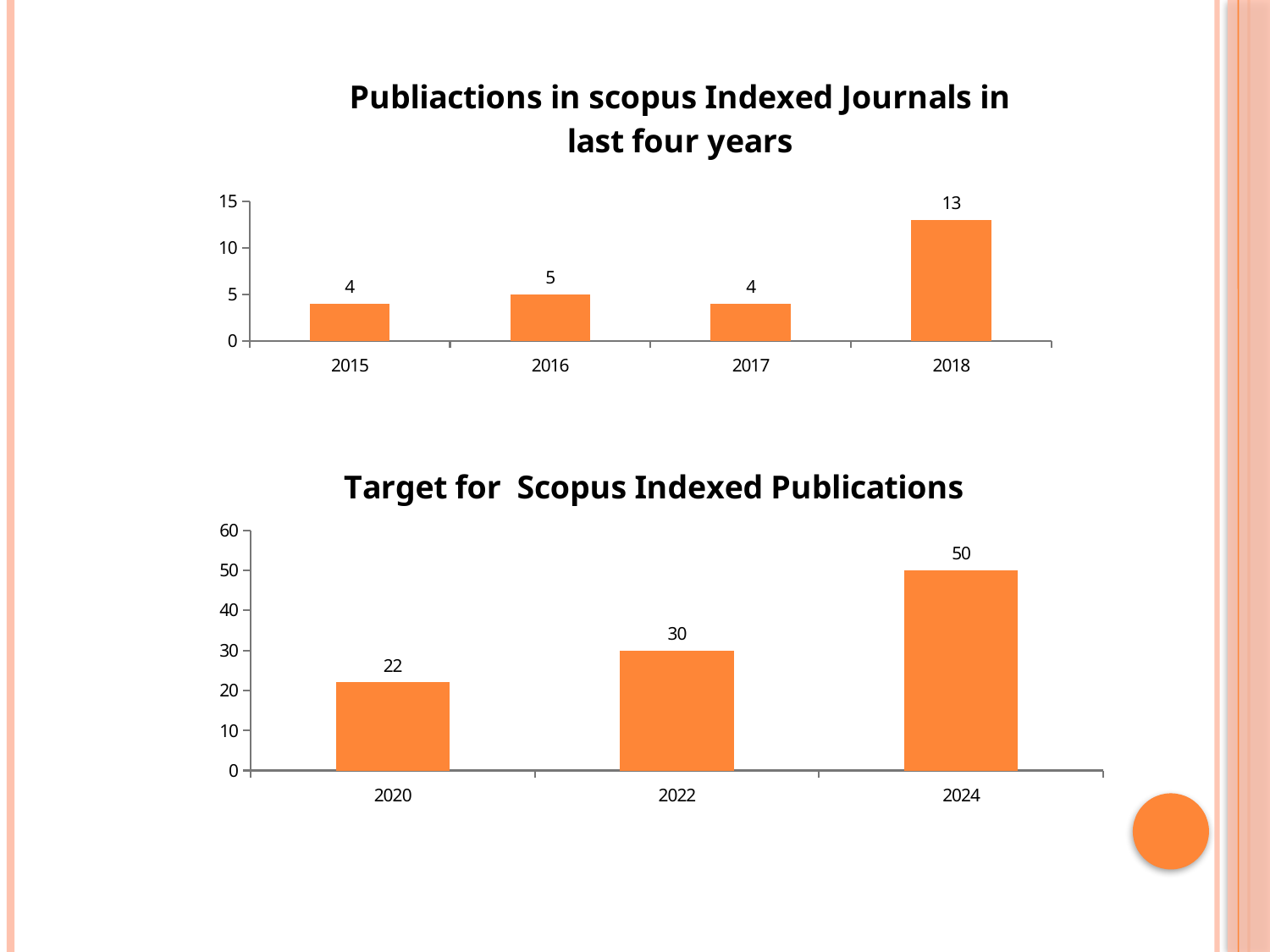
In the top chart (Publiactions in scopus Indexed Journals in last four years), what is the value for 2016? 5 In the bottom chart (Target for Scopus Indexed Publications), how many years are shown on the x axis? 3 In the top chart (Publiactions in scopus Indexed Journals in last four years), is the value for 2018 greater or less than 10? greater In the top chart (Publiactions in scopus Indexed Journals in last four years), how many years are shown on the x axis? 4 In the top chart (Publiactions in scopus Indexed Journals in last four years), what is the value for 2018? 13 What kind of chart is the bottom chart (Target for Scopus Indexed Publications)? bar chart In the bottom chart (Target for Scopus Indexed Publications), which year has the lowest value? 2020 In the bottom chart (Target for Scopus Indexed Publications), do the values rise or fall from 2020 to 2024? rise In the top chart (Publiactions in scopus Indexed Journals in last four years), which year has the highest value? 2018 In the bottom chart (Target for Scopus Indexed Publications), what is the value for 2022? 30 In the bottom chart (Target for Scopus Indexed Publications), what is the difference between the values for 2024 and 2020? 28 In the top chart (Publiactions in scopus Indexed Journals in last four years), what is the difference between the values for 2018 and 2017? 9